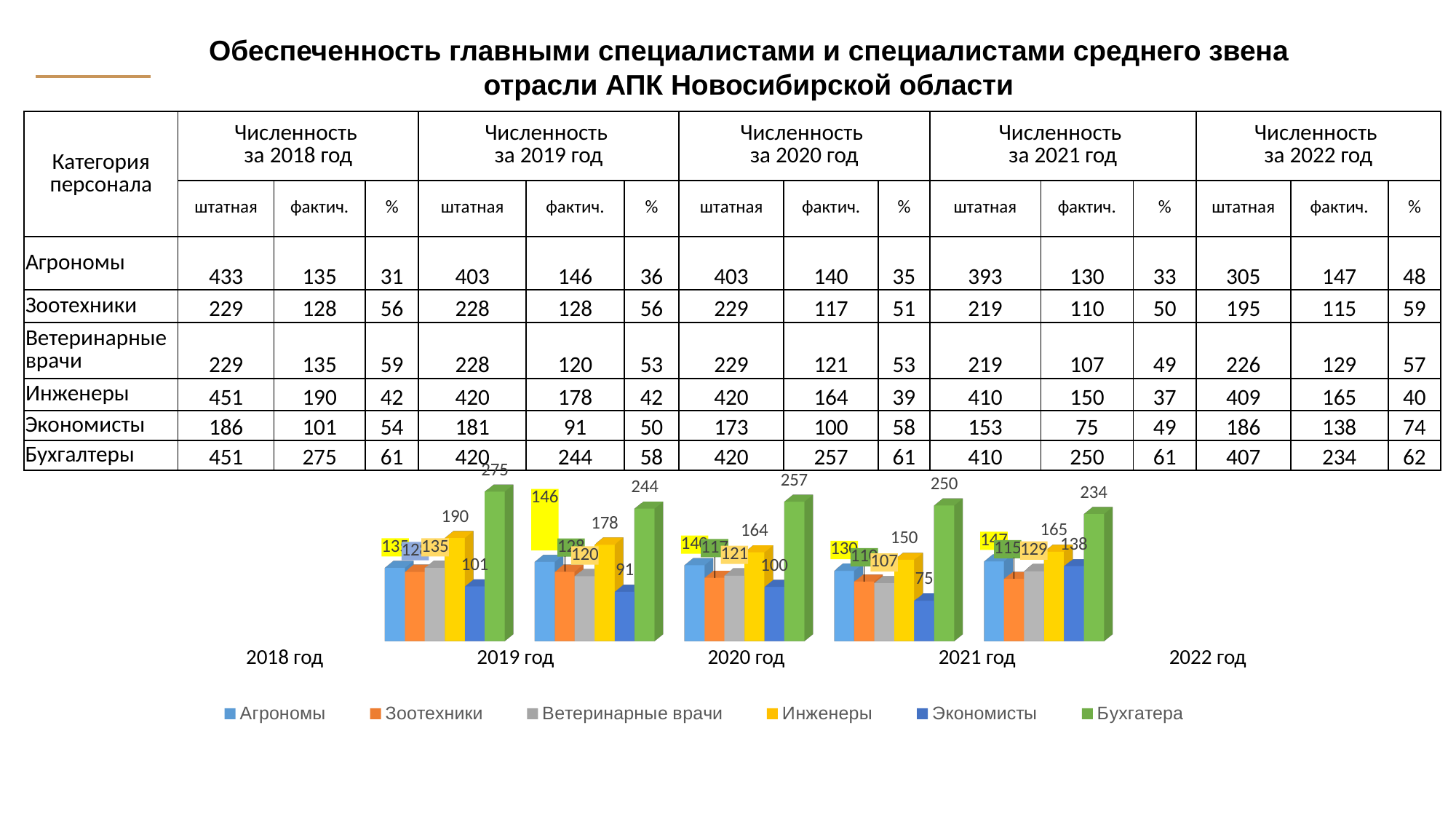
How many year groups are plotted on the chart's x axis? 5 In the chart, which series has the lowest value in the 2021 group? Экономисты In the chart, what is the value for Инженеры in the 2019 group? 178 In the chart, what is the value for Экономисты in the 2021 group? 75 What kind of chart is shown below the table on the slide? bar chart In the chart, which series has the highest value in the 2020 group? Бухгалтера In the chart, is the Инженеры value larger in the 2019 group or the 2020 group? 2019 In the chart, what is the value for Агрономы in the 2022 group? 147 In the chart, what colour represents the Бухгалтера series in the legend? green In the chart, what is the value for Бухгалтера in the 2018 group? 275 How many series does the chart legend list? 6 In the chart, what is the difference between the Бухгалтера value (234) and the Инженеры value (165) in the 2022 group? 69